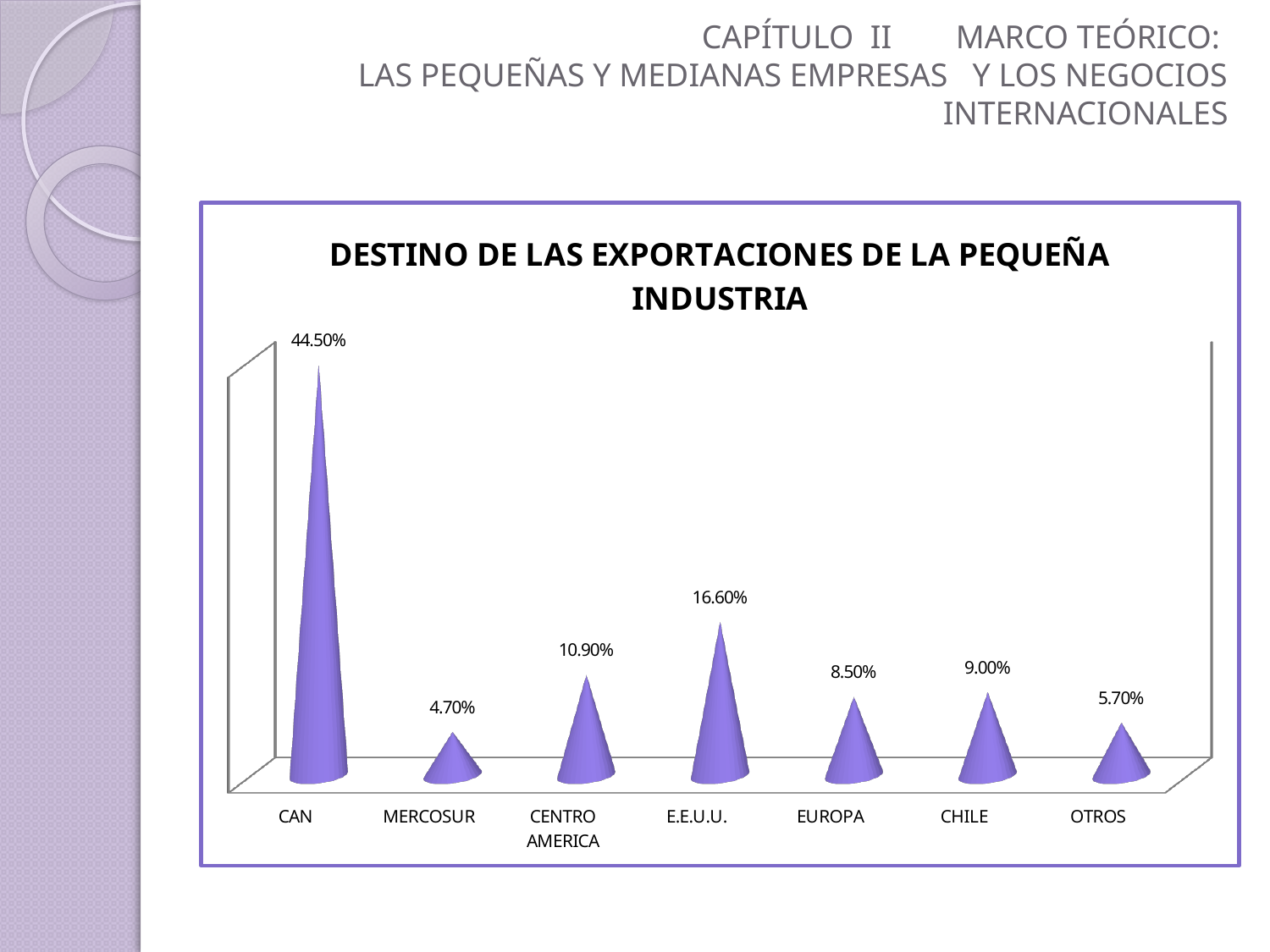
What is the value for E.E.U.U.? 16.60% What is the value for CENTRO AMERICA? 10.90% Which category has the highest value? CAN Which category has the lowest value? MERCOSUR What is the value for CAN? 44.50% Which is larger, the value for CENTRO AMERICA or the value for CHILE? CENTRO AMERICA What is the title of the chart? DESTINO DE LAS EXPORTACIONES DE LA PEQUEÑA INDUSTRIA What is the difference between the values for CHILE and EUROPA? 0.50% What is the difference between the values for CAN and E.E.U.U.? 27.90% How many categories are shown on the x axis? 7 What kind of chart is this? Bar chart What is the value for OTROS? 5.70%